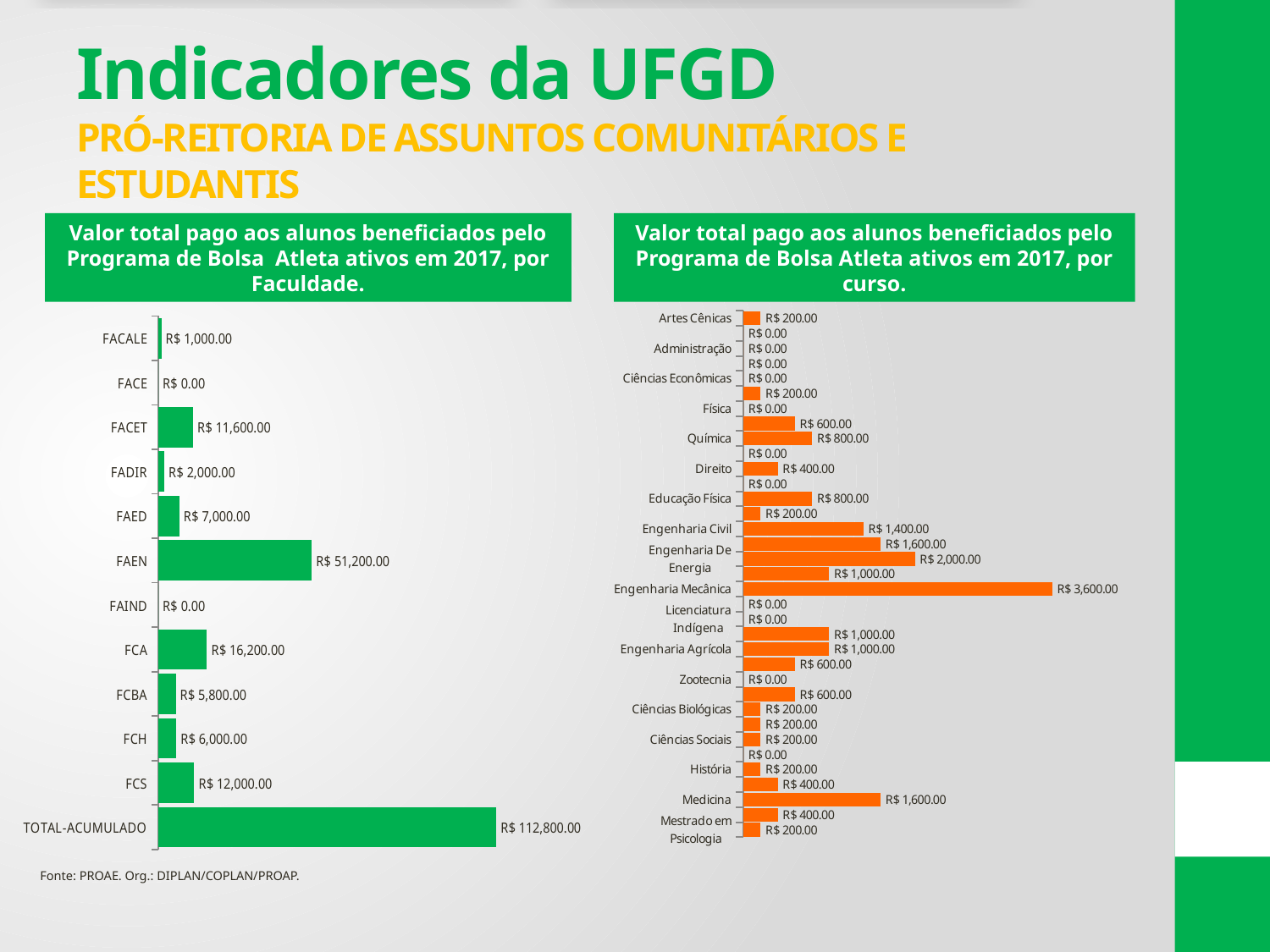
In the left chart (por Faculdade), how many categories are shown, including TOTAL-ACUMULADO? 12 In the left chart (por Faculdade), which is larger, the value for FCS or the value for FAED? FCS In the right chart (por curso), what is the value for Engenharia Mecânica? R$ 3,600.00 What kind of chart is the left chart (por Faculdade)? Bar chart In the left chart (por Faculdade), what is the value for FACET? R$ 11,600.00 In the right chart (por curso), which curso has the highest value? Engenharia Mecânica What colour are the bars in the right chart (por curso)? Orange In the left chart (por Faculdade), what is the value for FAEN? R$ 51,200.00 In the right chart (por curso), what is the value for Medicina? R$ 1,600.00 In the left chart (por Faculdade), what is the difference between the values for FCA and FACET? R$ 4,600.00 In the left chart (por Faculdade), which faculdade (excluding TOTAL-ACUMULADO) has the highest value? FAEN In the left chart (por Faculdade), what is the value for TOTAL-ACUMULADO? R$ 112,800.00